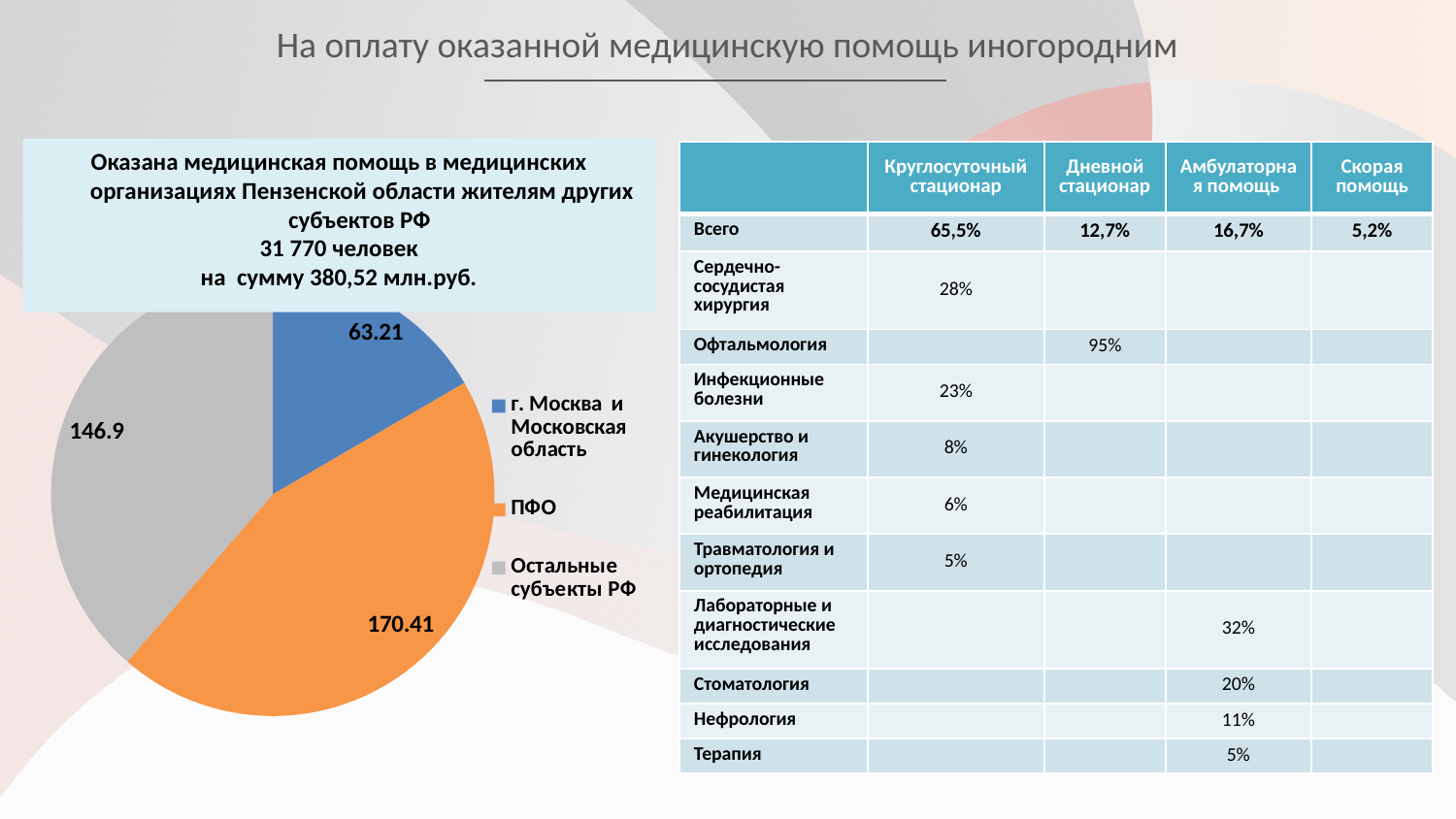
What is the total of all slices in the pie chart? 380.52 What type of chart is shown on the left of the slide? pie chart Which colour represents ПФО in the pie chart? orange In the pie chart, what is the difference between the values for Остальные субъекты РФ and г. Москва и Московская область? 83.69 In the pie chart, what is the difference between the values for ПФО and Остальные субъекты РФ? 23.51 In the pie chart, what is the value for г. Москва и Московская область? 63.21 Which category has the largest slice in the pie chart? ПФО In the pie chart, what is the value for ПФО? 170.41 How many slices does the pie chart have? 3 Which category has the smallest slice in the pie chart? г. Москва и Московская область In the pie chart, what is the value for Остальные субъекты РФ? 146.9 In the pie chart, which is larger: the value for Остальные субъекты РФ or the value for г. Москва и Московская область? Остальные субъекты РФ